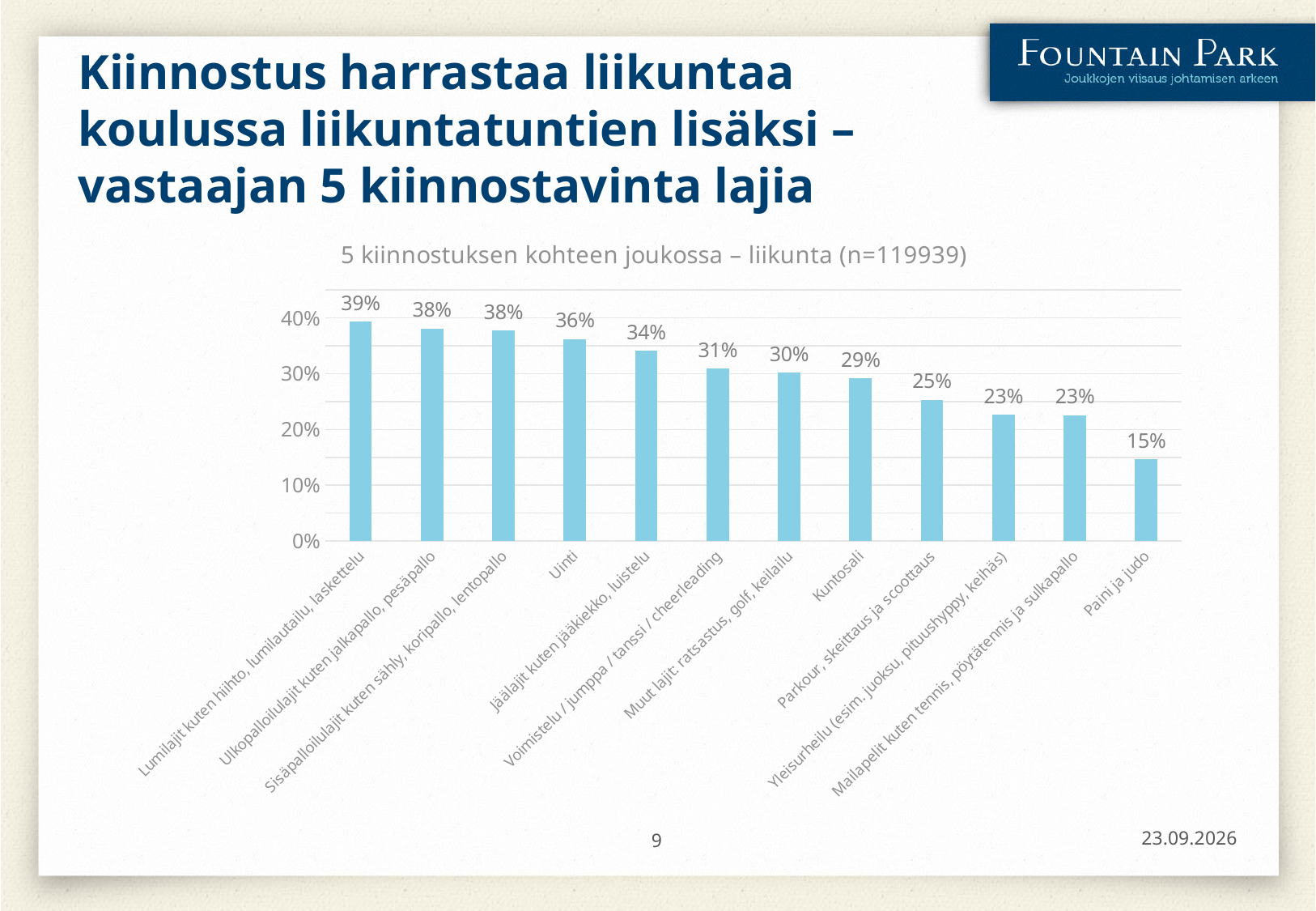
Which is larger, the value for Jäälajit kuten jääkiekko, luistelu or the value for Muut lajit: ratsastus, golf, keilailu? Jäälajit kuten jääkiekko, luistelu What is the value for Kuntosali? 29% What is the difference between the values for Uinti and Kuntosali? 7 percentage points Do the values rise or fall from left to right along the x axis? Fall Which category has the lowest value? Paini ja judo What is the value for Paini ja judo? 15% What is the sample size (n) given in the chart title? 119939 How many categories are shown in the chart? 12 Which category has the highest value? Lumilajit kuten hiihto, lumilautailu, laskettelu What kind of chart is shown on the slide? Bar chart What is the value for Parkour, skeittaus ja scoottaus? 25% What is the value for Uinti? 36%